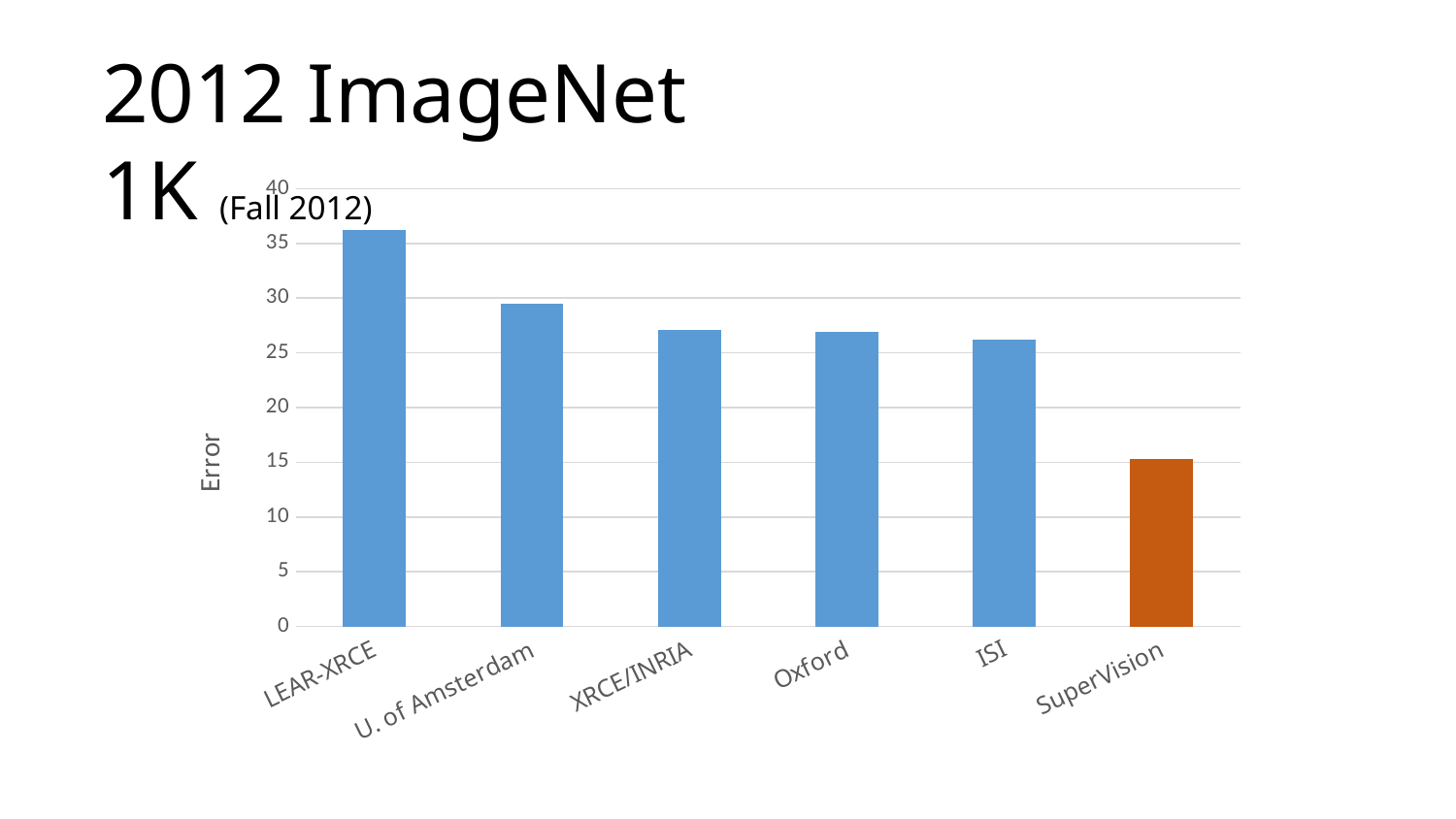
Is the error for LEAR-XRCE greater or less than 35? greater Is the error for ISI greater or less than 25? greater Is the error for SuperVision greater or less than 20? less Which team has the lowest error in the chart? SuperVision Which team's bar is coloured orange instead of blue? SuperVision How many teams are shown on the x axis of the chart? 6 Which team has the highest error in the chart? LEAR-XRCE Do the error values generally rise or fall from left to right across the chart? fall Which has a higher error, LEAR-XRCE or U. of Amsterdam? LEAR-XRCE Which has a lower error, ISI or SuperVision? SuperVision What kind of chart is shown on the slide? bar chart